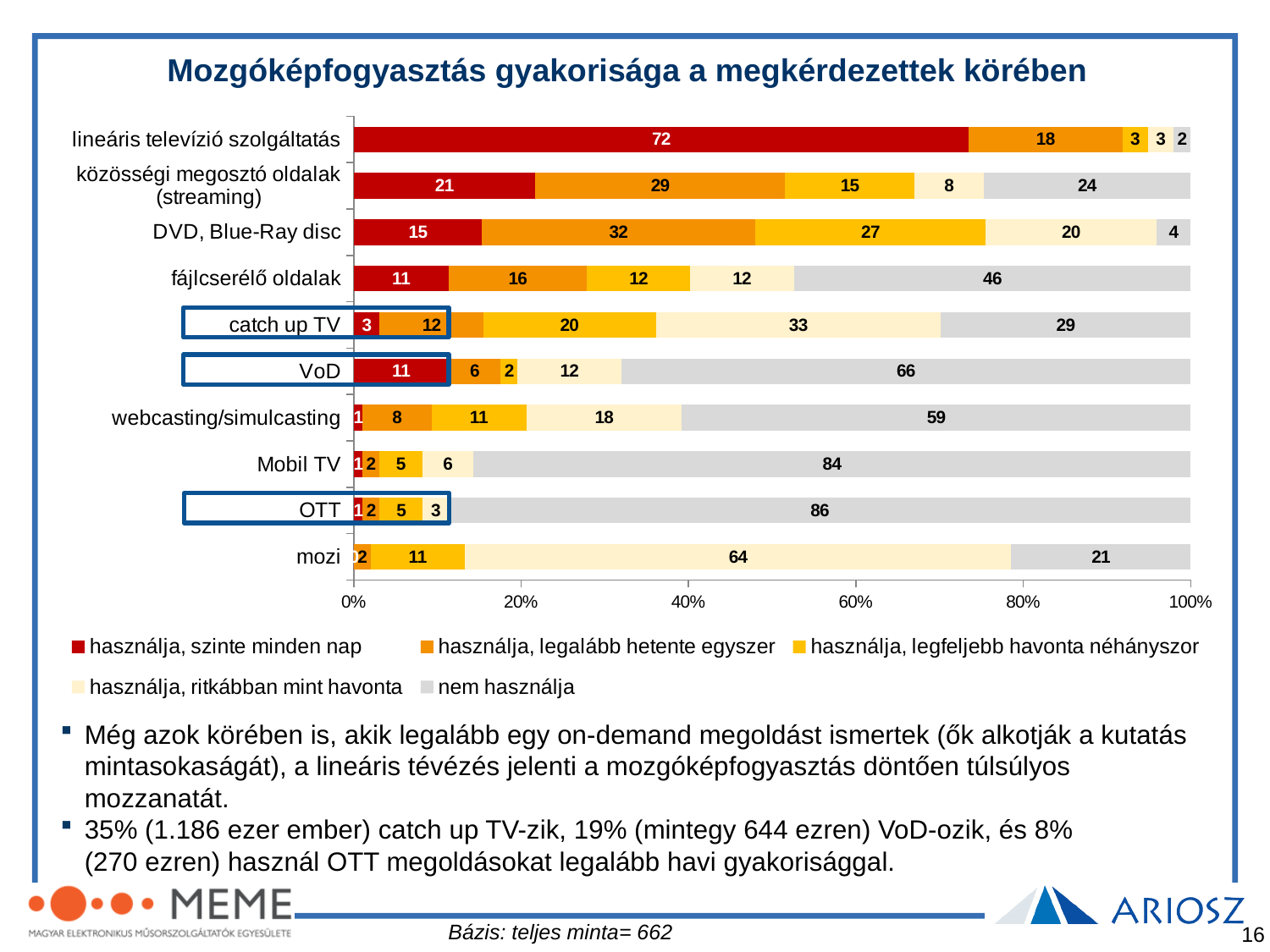
Which category has the lowest value for 'nem használja'? lineáris televízió szolgáltatás What is the difference between the 'nem használja' values for 'VoD' and 'catch up TV'? 37 Which has a larger 'használja, legfeljebb havonta néhányszor' value: 'DVD, Blue-Ray disc' or 'közösségi megosztó oldalak (streaming)'? DVD, Blue-Ray disc How many categories (rows) are plotted in the chart? 10 What is the value of 'nem használja' for 'OTT'? 86 What is the title of the chart? Mozgóképfogyasztás gyakorisága a megkérdezettek körében What is the value of 'használja, szinte minden nap' for 'lineáris televízió szolgáltatás'? 72 What is the value of 'használja, ritkábban mint havonta' for 'mozi'? 64 What is the value of 'használja, legalább hetente egyszer' for 'DVD, Blue-Ray disc'? 32 What type of chart is shown on the slide? stacked bar chart Which category has the highest value for 'használja, szinte minden nap'? lineáris televízió szolgáltatás How many series does the legend list? 5